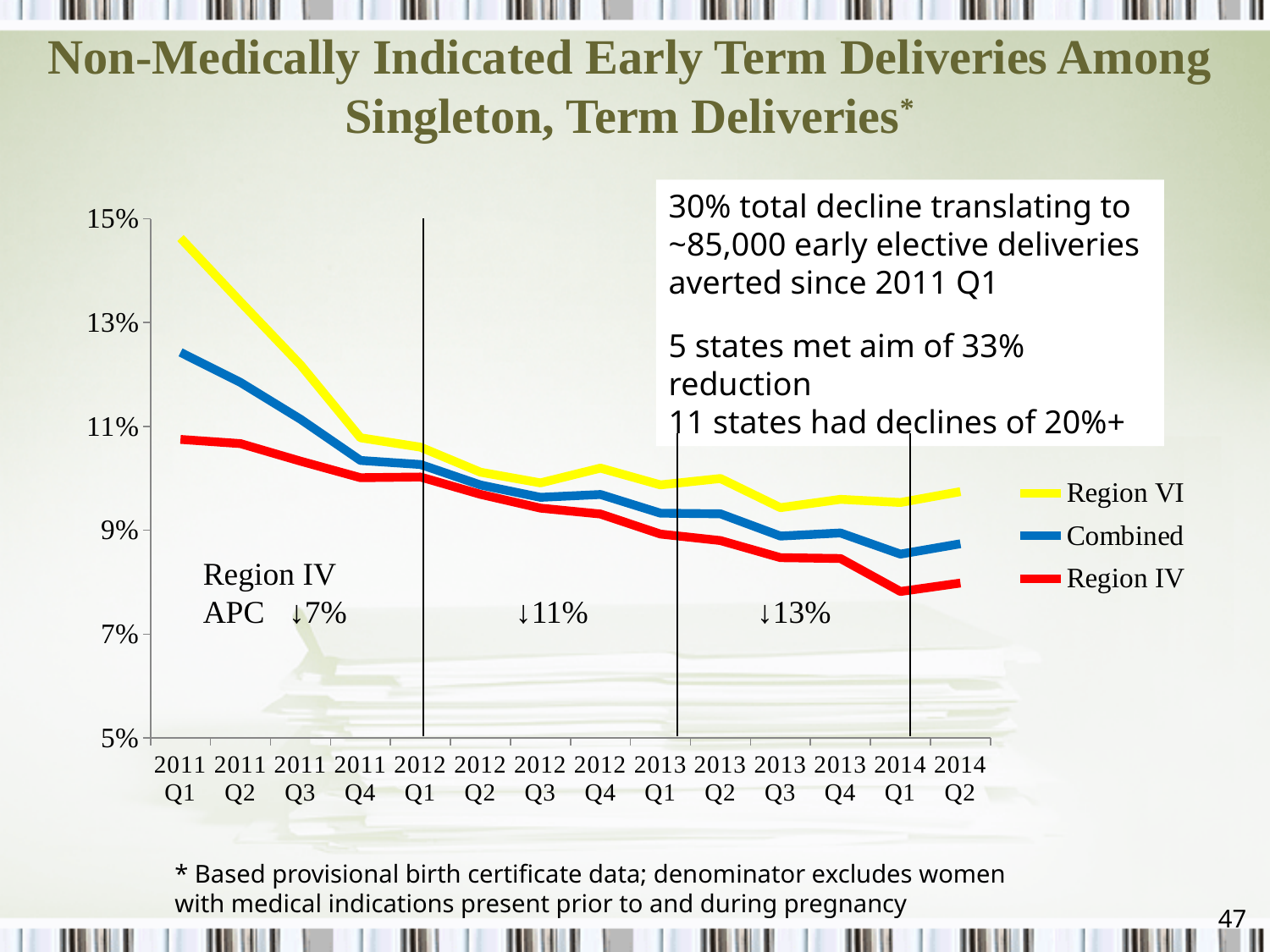
What colour is the Combined line in the legend? blue Is the value for Combined at 2011 Q1 greater or less than 11%? greater Is the value for Region IV at 2014 Q1 greater or less than 9%? less How many series does the legend list? 3 Do the values for Region VI rise or fall from 2011 Q1 to 2014 Q2? fall Which is larger at 2011 Q1, Region VI or Region IV? Region VI What APC is annotated for Region IV in the first segment of the chart? ↓7% Which series has the highest value at 2011 Q1? Region VI Which series has the lowest value at 2014 Q1? Region IV What kind of chart is shown on the slide? line chart Is the value for Region VI at 2011 Q1 greater or less than 13%? greater How many quarters are plotted along the x axis? 14